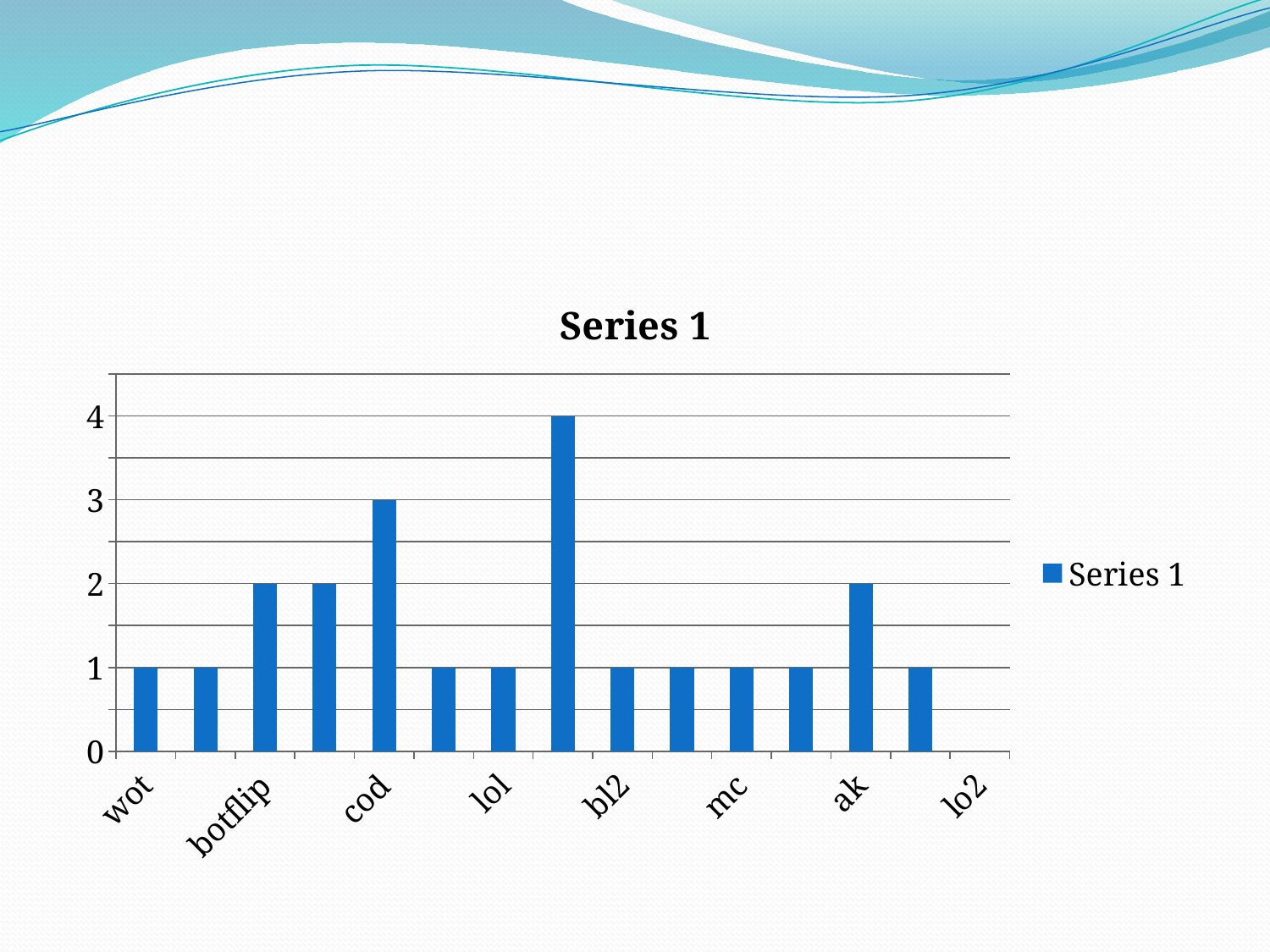
What is the value for mc? 1 Which is larger, the value for cod or the value for ak? cod What is the value for lol? 1 What is the value for botflip? 2 What is the value for cod? 3 What is the value for bl2? 1 How many series does the legend list? 1 What is the value for ak? 2 What is the difference between the value for cod and the value for wot? 2 What kind of chart is shown on the slide? bar chart What is the value for wot? 1 What is the title of the chart? Series 1